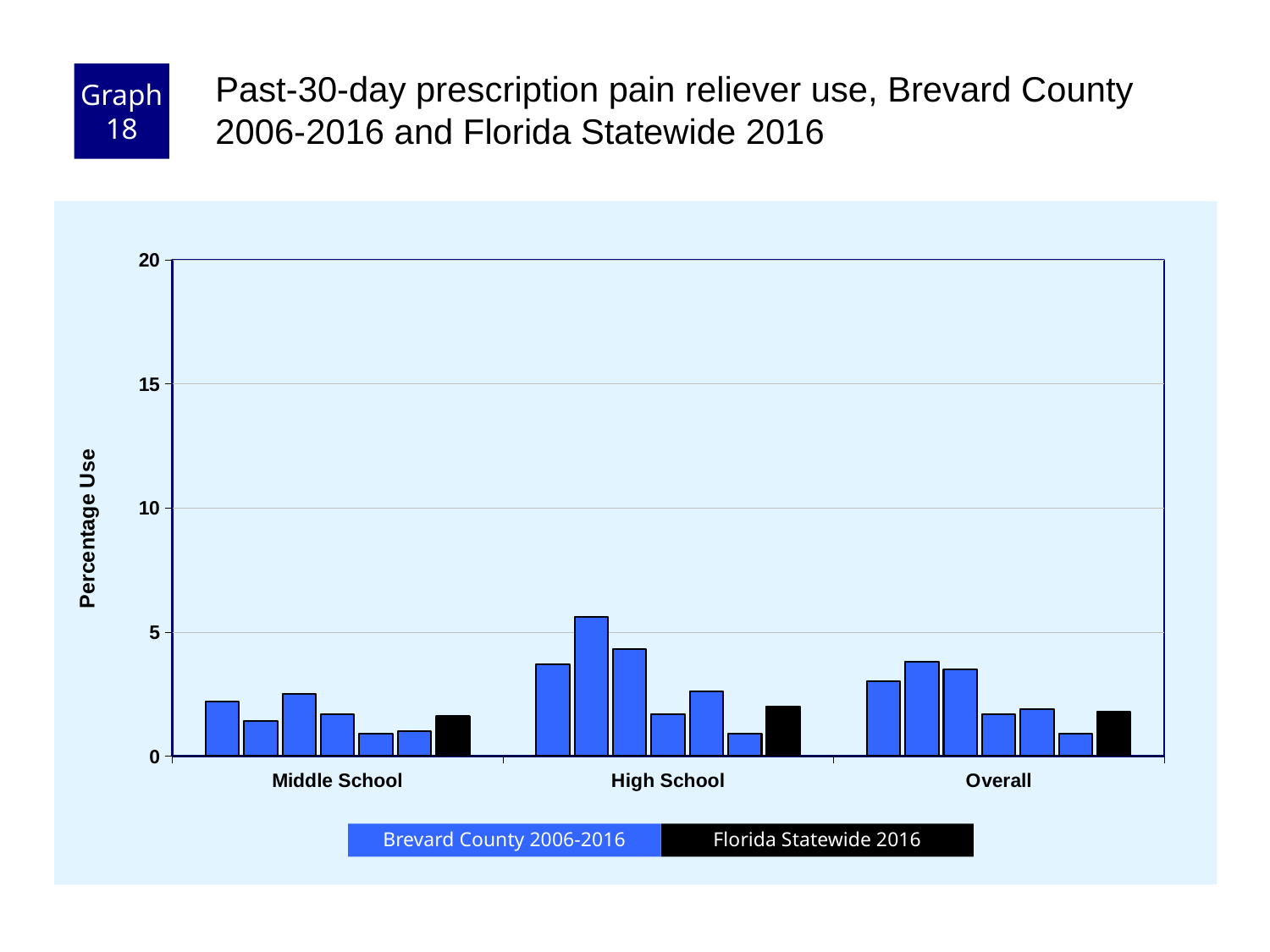
What is the label on the y axis? Percentage Use How many categories are shown along the x axis? 3 What kind of chart is shown on the slide? bar chart Which category group contains the tallest bar in the chart? High School Which colour represents Florida Statewide 2016 in the legend? black Which is taller: the tallest Brevard County bar for High School or the tallest Brevard County bar for Middle School? High School Is the tallest bar in the Middle School group greater or less than 5? less Is the Florida Statewide 2016 value for High School greater or less than 5? less Is the tallest bar in the High School group greater or less than 5? greater How many series does the legend list? 2